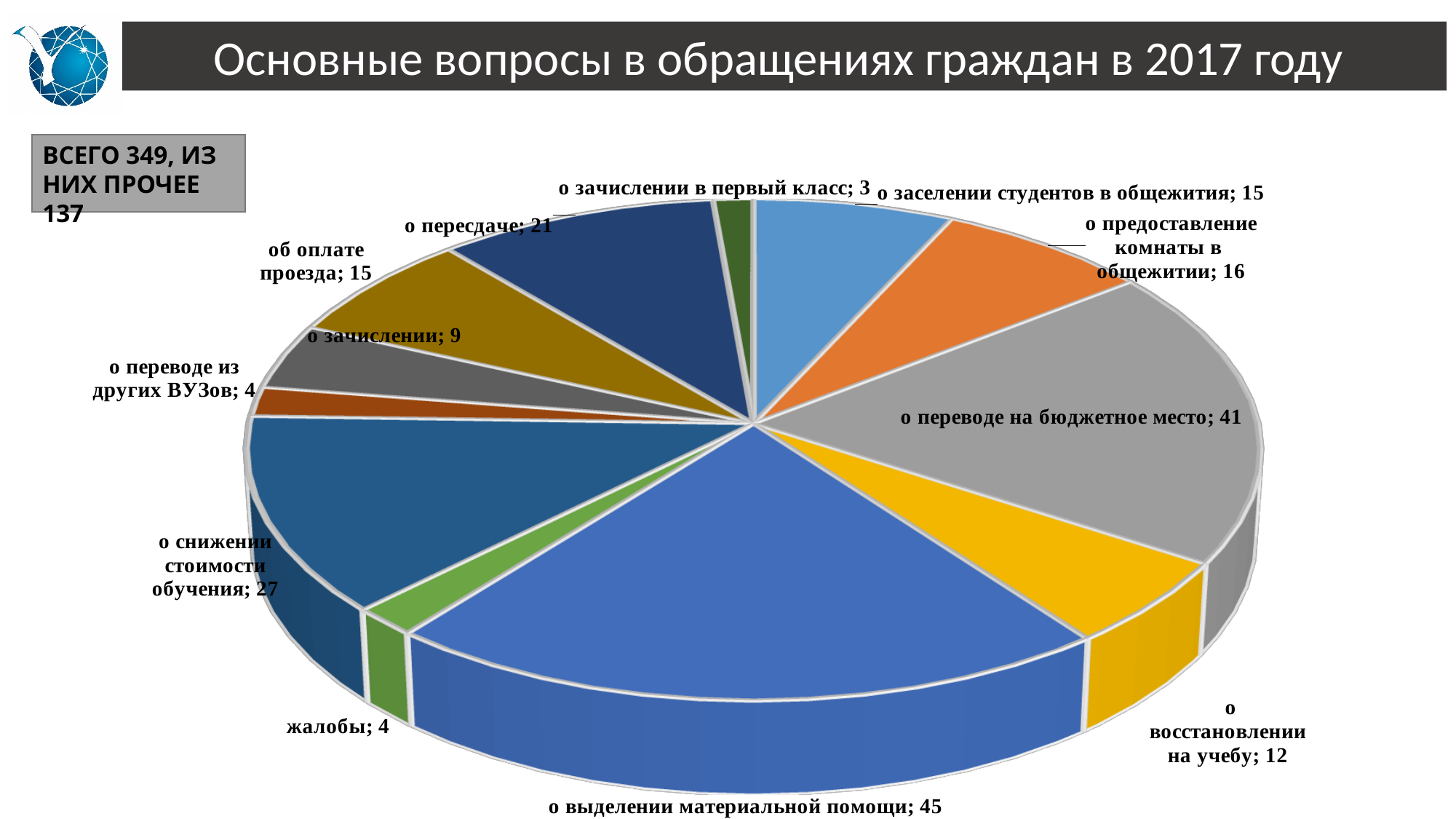
What is the value for "о переводе на бюджетное место"? 41 What is the value for "о пересдаче"? 21 What kind of chart is shown on the slide? pie chart Which category has the largest value in the pie chart? о выделении материальной помощи Which is larger: the value for "о пересдаче" or the value for "о предоставление комнаты в общежитии"? о пересдаче Which category has the smallest value in the pie chart? о зачислении в первый класс What is the value for "о снижении стоимости обучения"? 27 How many categories (slices) are labelled in the pie chart? 12 What is the difference between the values for "о выделении материальной помощи" and "о переводе на бюджетное место"? 4 What is the value for "о выделении материальной помощи"? 45 What is the title of the slide? Основные вопросы в обращениях граждан в 2017 году What is the difference between the values for "о снижении стоимости обучения" and "о восстановлении на учебу"? 15